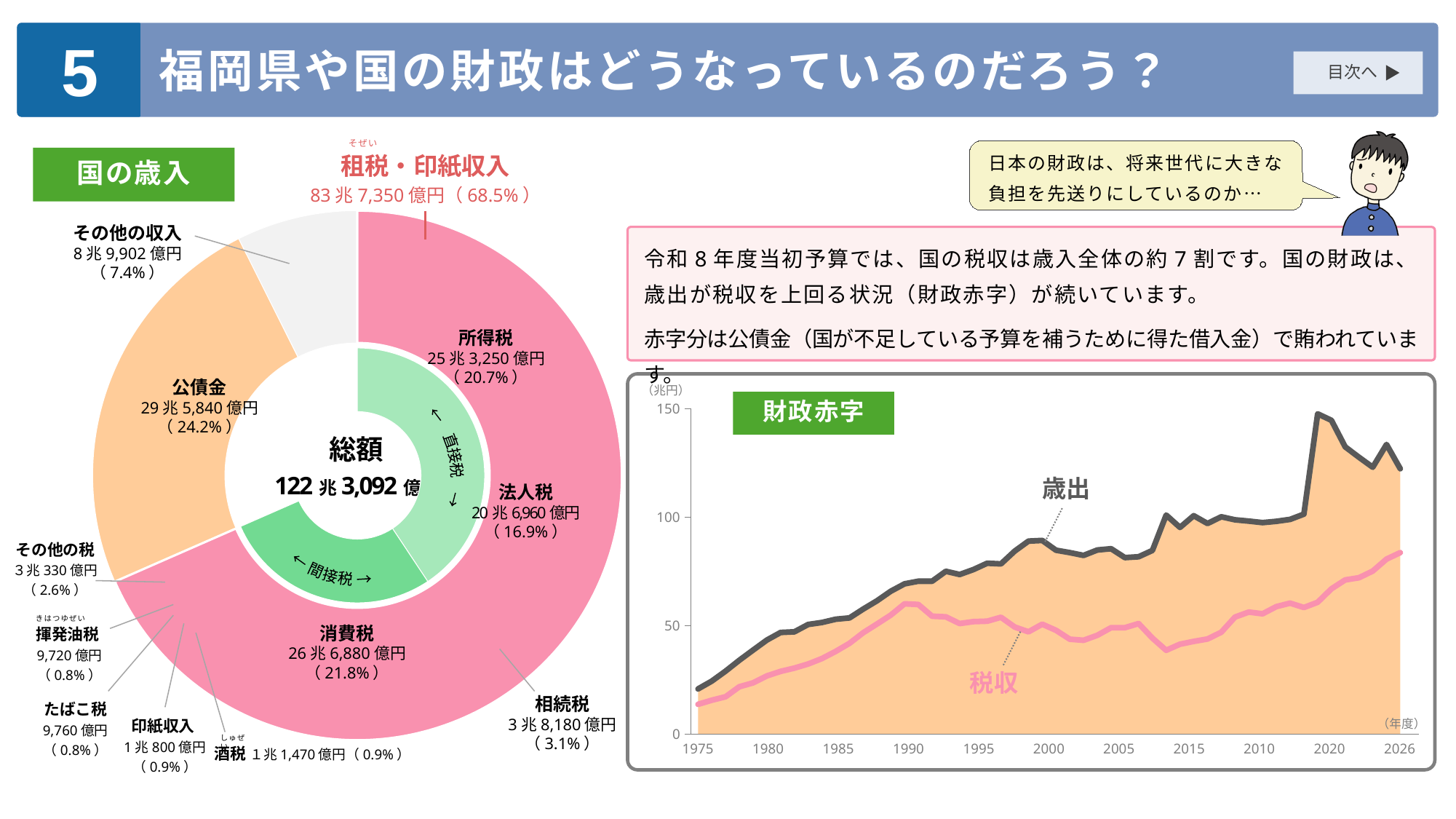
「国の歳入」のグラフはどのような種類のグラフですか？ 円グラフ（ドーナツグラフ） 「国の歳入」のグラフで、所得税と法人税ではどちらの金額が大きいですか？ 所得税 「国の歳入」のグラフで、相続税の金額はいくらですか？ 3兆8,180億円 「国の歳入」のグラフで、消費税の割合は何％ですか？ 21.8% 「財政赤字」のグラフで、2020年の歳出は100兆円より多いですか、少ないですか？ 多い 「財政赤字」のグラフで、1975年から2026年にかけて歳出は全体として増加していますか、減少していますか？ 増加 「国の歳入」のグラフで、租税・印紙収入の割合は何％ですか？ 68.5% 「国の歳入」のグラフで、歳入の総額はいくらですか？ 122兆3,092億円 「国の歳入」のグラフで、税の内訳のうち最も割合が小さい項目はどれですか（同率の場合は両方答えてください）？ 揮発油税とたばこ税（0.8%） 「国の歳入」のグラフで、所得税と法人税の割合の差は何ポイントですか？ 3.8ポイント 「国の歳入」のグラフで、公債金の金額はいくらですか？ 29兆5,840億円 「財政赤字」のグラフには何本の系列が描かれていますか？ 2本（歳出と税収）